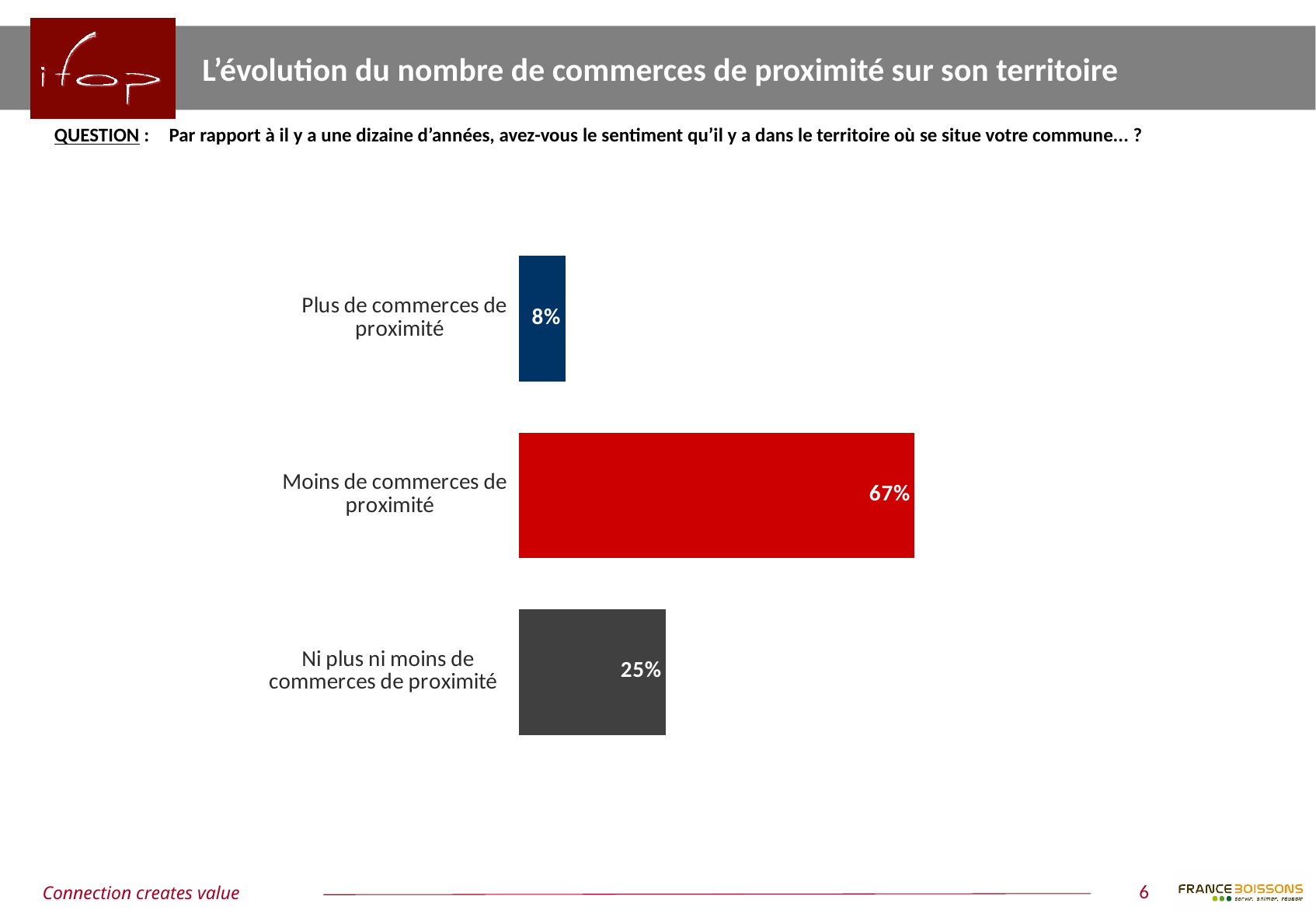
What is the value for "Ni plus ni moins de commerces de proximité"? 25% What is the difference between "Moins de commerces de proximité" and "Ni plus ni moins de commerces de proximité"? 42 percentage points Which category has the highest value? Moins de commerces de proximité What is the value for "Moins de commerces de proximité"? 67% What percentage of respondents said there are more local shops ("Plus de commerces de proximité")? 8% What colour is the bar for "Moins de commerces de proximité"? Red How many categories are shown in the chart? 3 Which category has the lowest value? Plus de commerces de proximité Which is larger: "Plus de commerces de proximité" or "Ni plus ni moins de commerces de proximité"? Ni plus ni moins de commerces de proximité What is the difference between "Ni plus ni moins de commerces de proximité" and "Plus de commerces de proximité"? 17 percentage points What is the total of the three percentages shown in the chart? 100% What kind of chart is shown on the slide? Bar chart